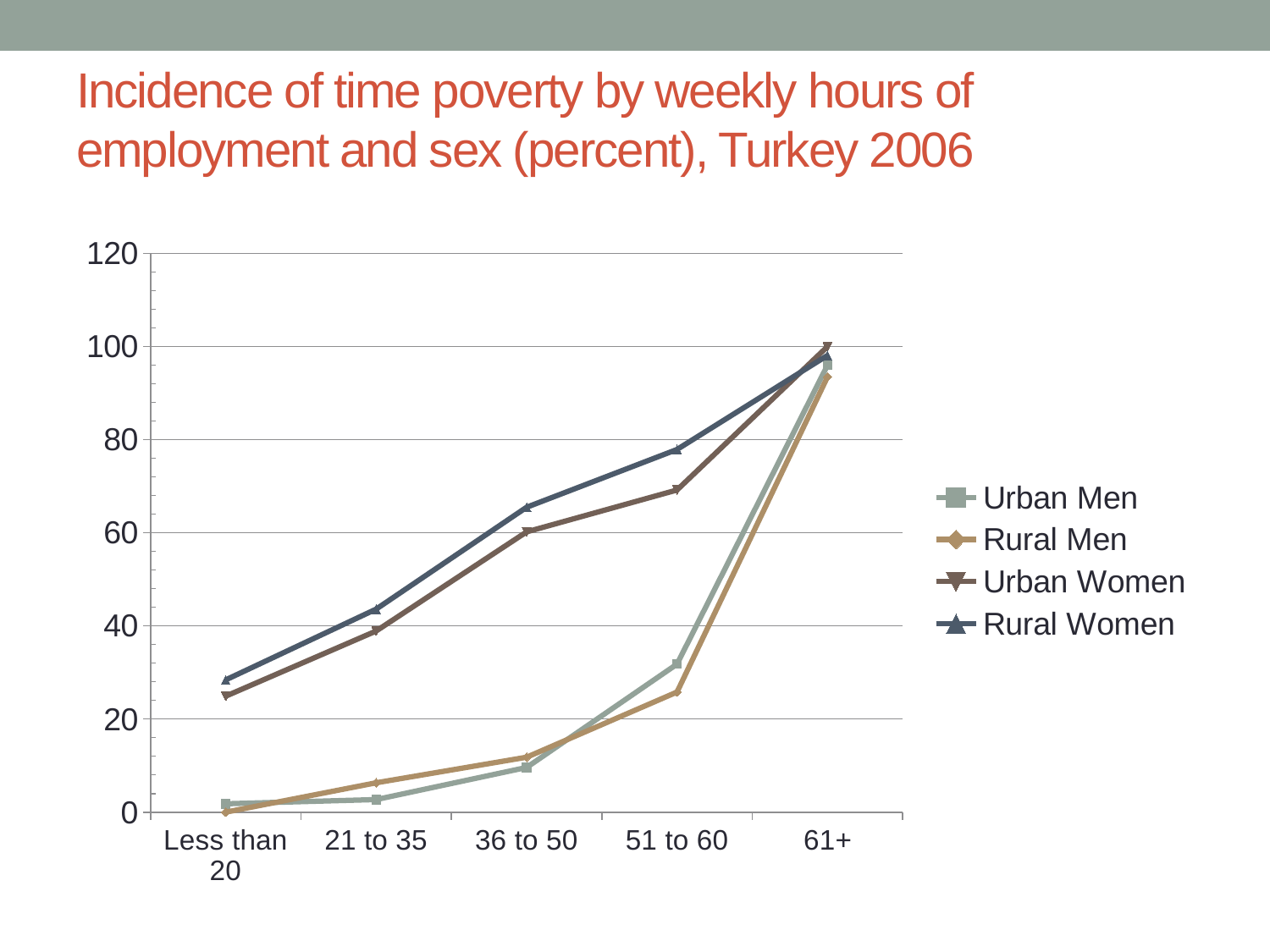
Is the value for Rural Men at 36 to 50 hours greater or less than 20? less Do the values for Rural Women rise or fall as weekly hours of employment increase along the x axis? rise At 36 to 50 hours, which is larger: the value for Rural Women or the value for Urban Men? Rural Women Which weekly-hours category has the lowest value for Rural Women? Less than 20 Is the value for Urban Men at 51 to 60 hours greater or less than 40? less What kind of chart is shown on the slide? line chart How many weekly-hours categories are shown on the x axis? 5 Is the value for Rural Women at 36 to 50 hours greater or less than 60? greater How many series does the legend list? 4 At 51 to 60 hours, which is larger: the value for Urban Women or the value for Rural Women? Rural Women Which weekly-hours category has the highest value for Urban Women? 61+